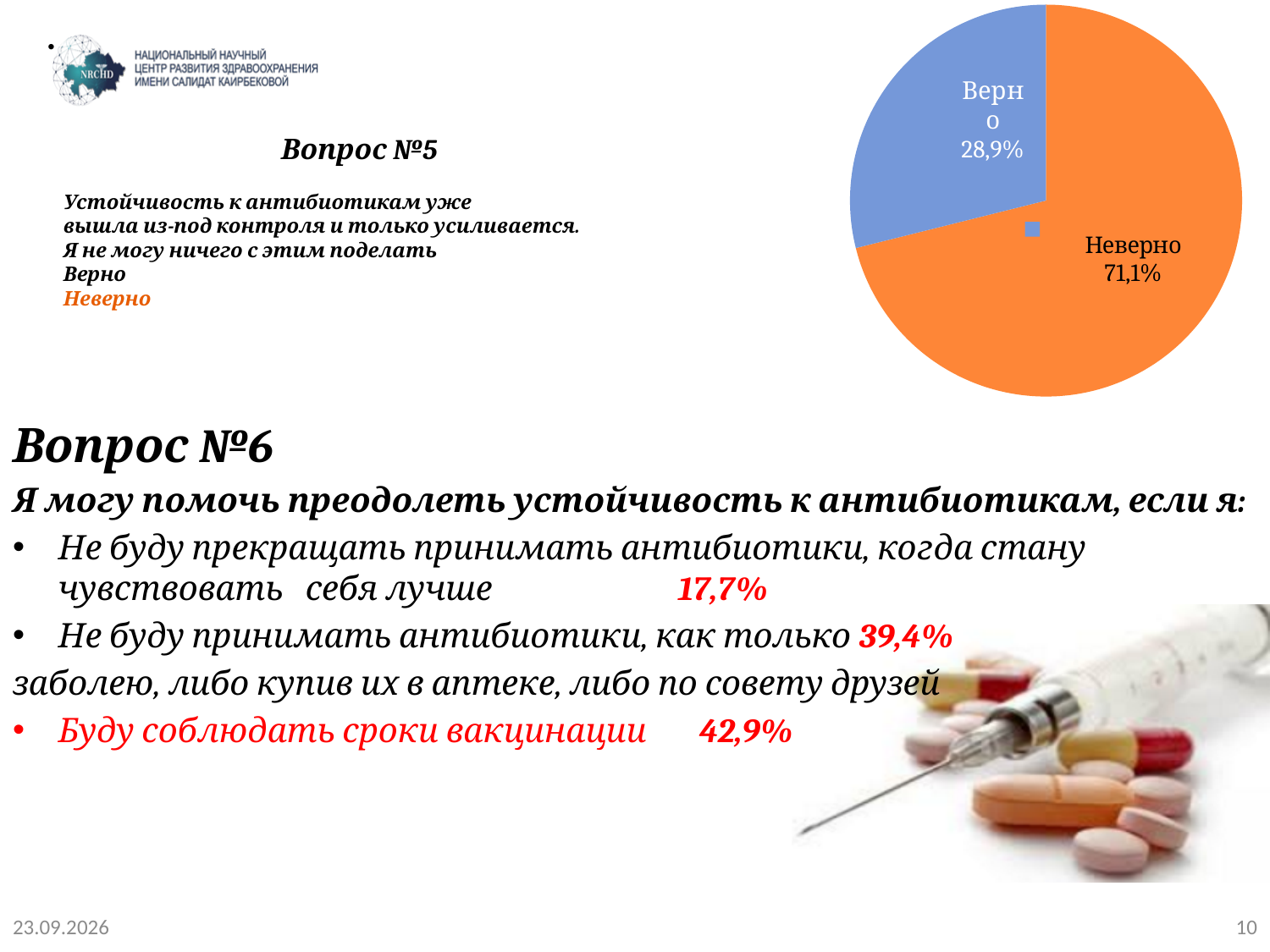
Which slice of the pie chart is the largest? Неверно What is the difference in percentage points between the "Неверно" and "Верно" slices of the pie chart? 42,2 What kind of chart is shown on the slide? pie chart Which is larger in the pie chart, "Верно" or "Неверно"? Неверно Is the share for "Неверно" in the pie chart greater or less than 50%? greater Is the share for "Верно" in the pie chart greater or less than 50%? less What colour is the "Верно" slice of the pie chart? blue What share of the pie chart is labelled "Верно"? 28,9% What colour is the "Неверно" slice of the pie chart? orange What share of the pie chart is labelled "Неверно"? 71,1% Which slice of the pie chart is the smallest? Верно How many slices does the pie chart have? 2